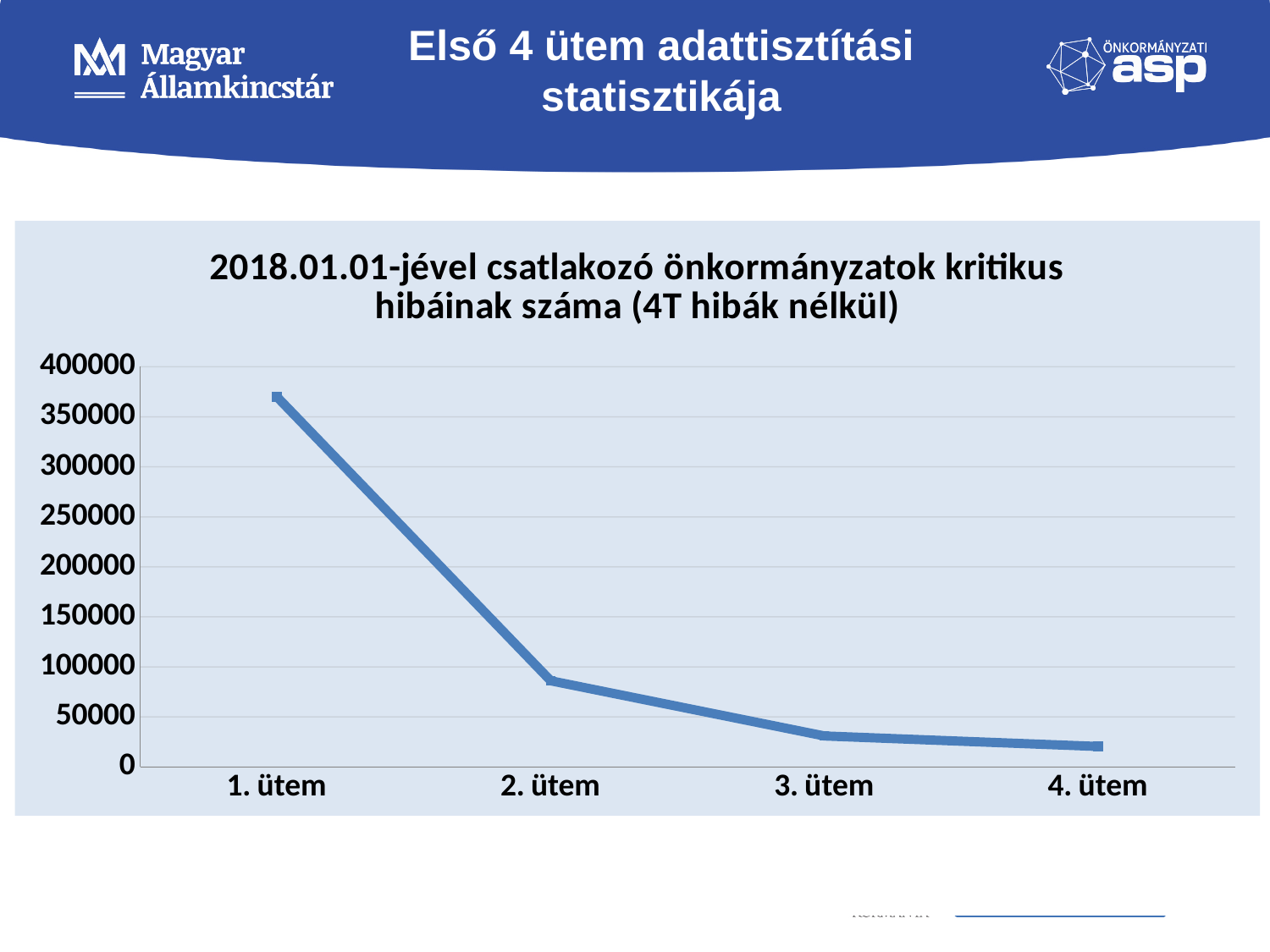
Which ütem has the lowest number of critical errors? 4. ütem Is the value for 2. ütem greater or less than 50000? greater Which is larger, the value for 1. ütem or the value for 2. ütem? 1. ütem Is the value for 3. ütem greater or less than 50000? less Is the value for 1. ütem greater or less than 350000? greater Which is larger, the value for 2. ütem or the value for 3. ütem? 2. ütem Do the values rise or fall from 1. ütem to 4. ütem? fall Which ütem has the highest number of critical errors? 1. ütem What kind of chart is shown on the slide? line chart How many points (ütem categories) are plotted on the x axis? 4 What is the title of the chart? 2018.01.01-jével csatlakozó önkormányzatok kritikus hibáinak száma (4T hibák nélkül)